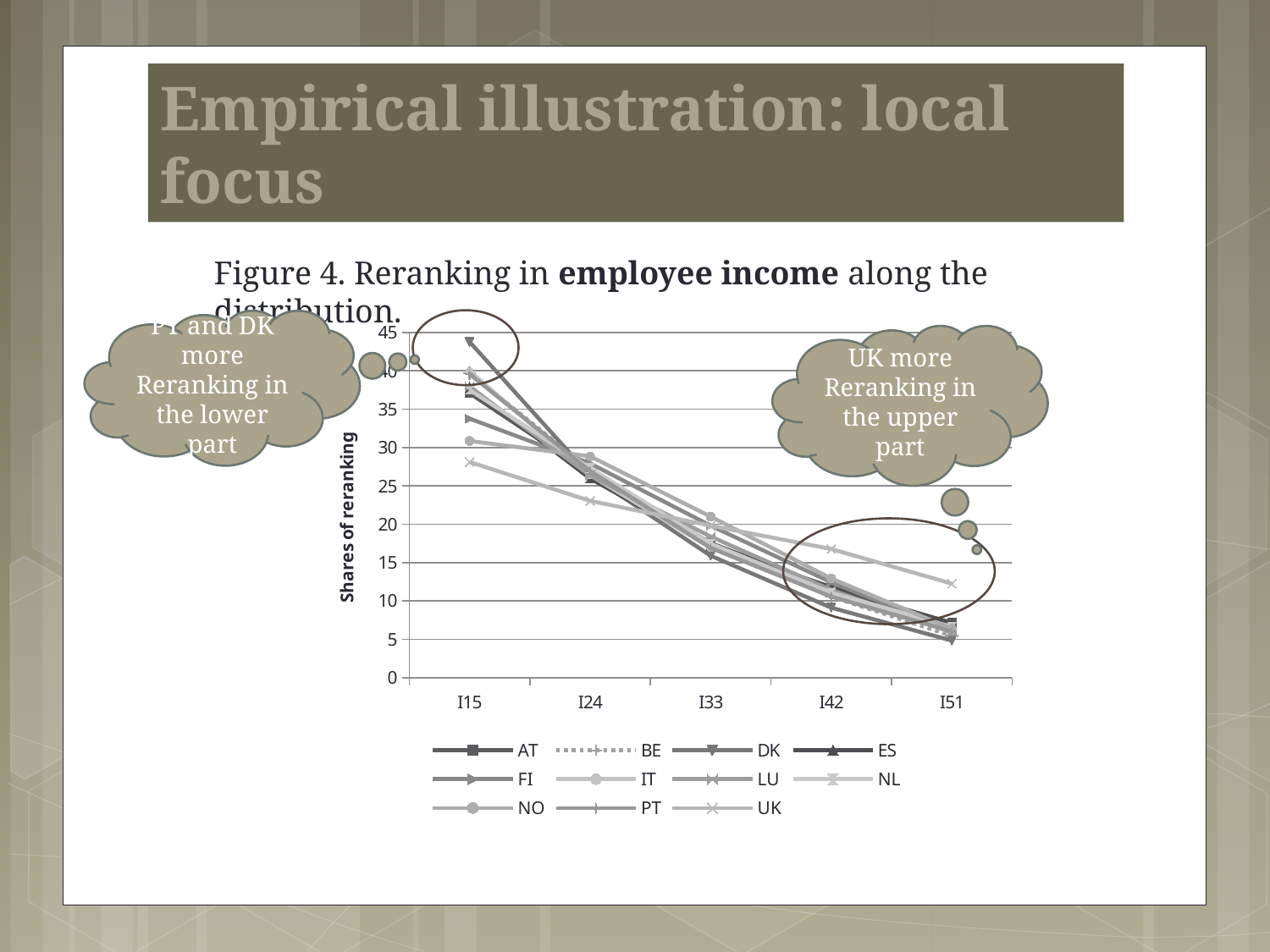
Which category is the first on the x axis? I15 Which series has the highest value at I15? DK Do the values generally rise or fall from I15 to I51? fall Is the value for DK at I15 greater or less than 40? greater How many series does the legend list? 11 Is the value for UK at I15 greater or less than 30? less What is the label of the y axis? Shares of reranking How many categories are shown on the x axis? 5 Is the value for UK at I51 greater or less than 10? greater What kind of chart is shown on the slide? line chart Which series has the highest value at I51? UK Which series has the lowest value at I15? UK